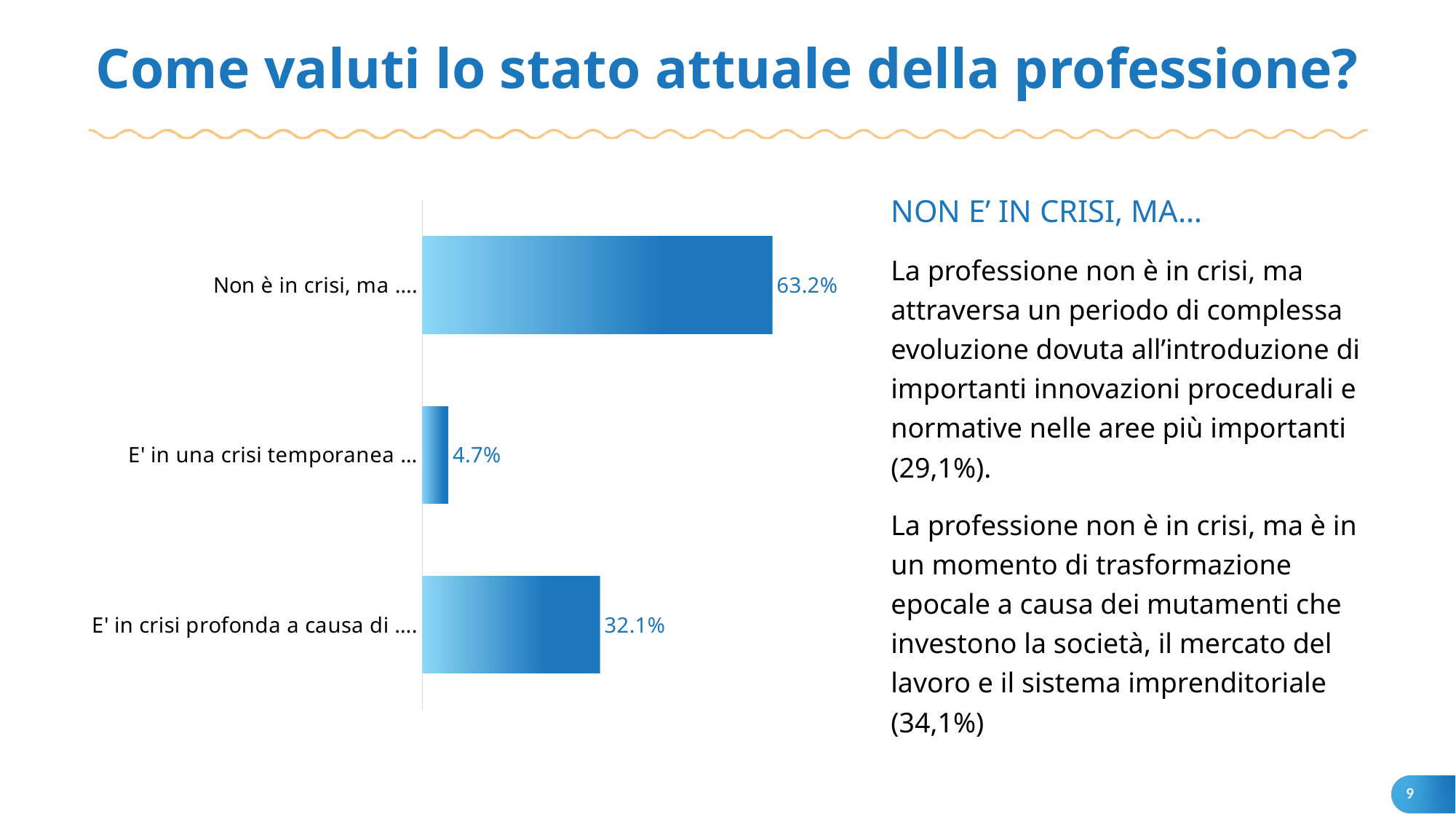
Which category has the lowest value? E' in una crisi temporanea ... What is the difference between the values for "E' in crisi profonda a causa di ...." and "E' in una crisi temporanea ..."? 27.4% What is the value for "E' in crisi profonda a causa di ...."? 32.1% What is the value for "E' in una crisi temporanea ..."? 4.7% What is the title of the slide containing the chart? Come valuti lo stato attuale della professione? What kind of chart is shown on the slide? Bar chart What is the difference between the values for "Non è in crisi, ma ...." and "E' in crisi profonda a causa di ...."? 31.1% Which category has the highest value? Non è in crisi, ma .... What is the value for "Non è in crisi, ma ...."? 63.2% How many categories are shown in the chart? 3 Are the bars in the chart horizontal or vertical? Horizontal Which is larger, the value for "E' in crisi profonda a causa di ...." or the value for "E' in una crisi temporanea ..."? E' in crisi profonda a causa di ....